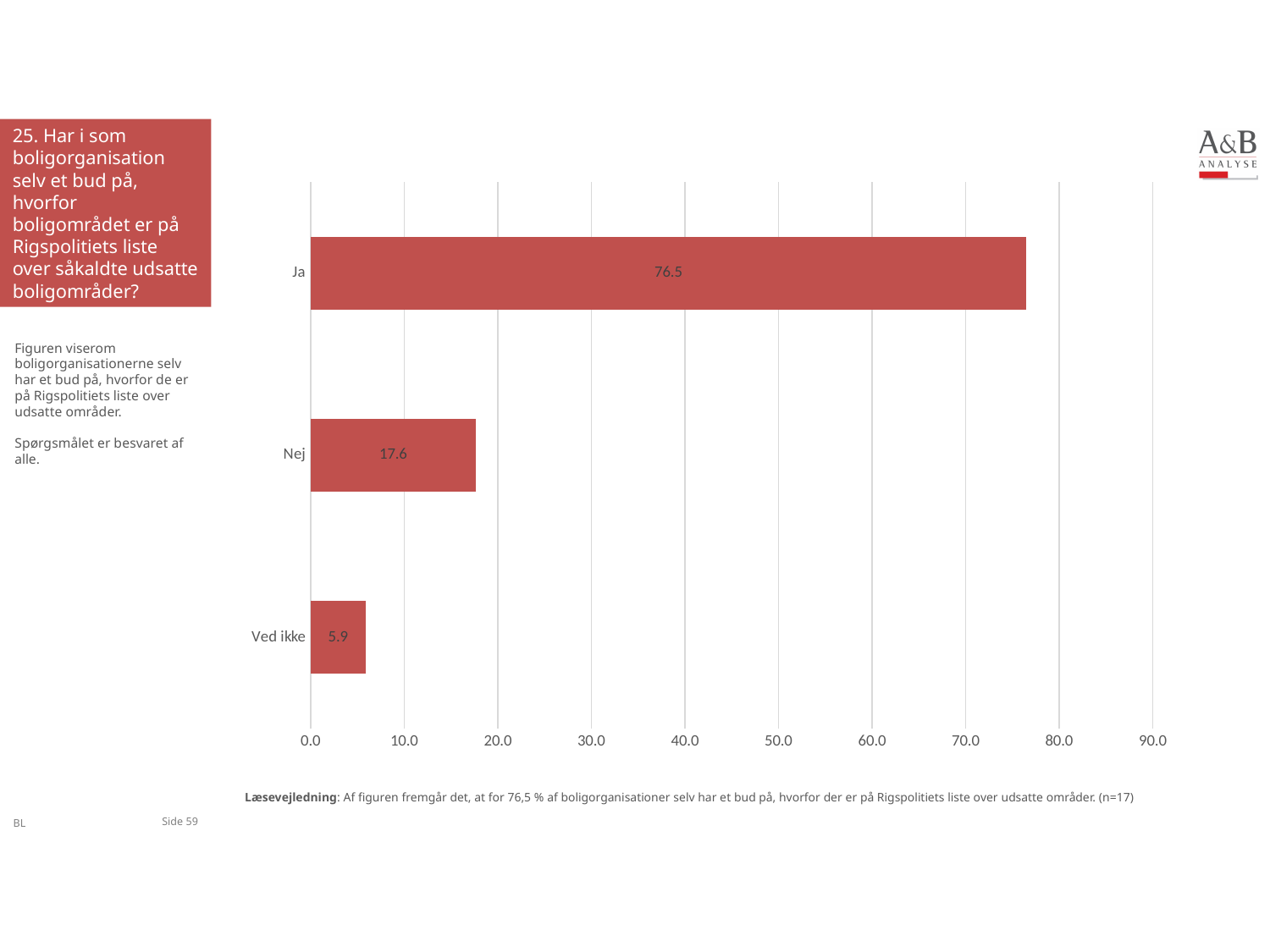
What is the value for Ved ikke? 5.9 Which is larger, the value for Nej or the value for Ved ikke? Nej Is the value for Ja greater or less than 70.0? greater What is the highest value shown on the x axis? 90.0 What is the difference between the values for Nej and Ved ikke? 11.7 How many categories are shown in the chart? 3 What is the value for Ja? 76.5 Which category has the highest value? Ja Which category has the lowest value? Ved ikke What is the value for Nej? 17.6 What kind of chart is shown on the slide? bar chart What is the difference between the values for Ja and Nej? 58.9